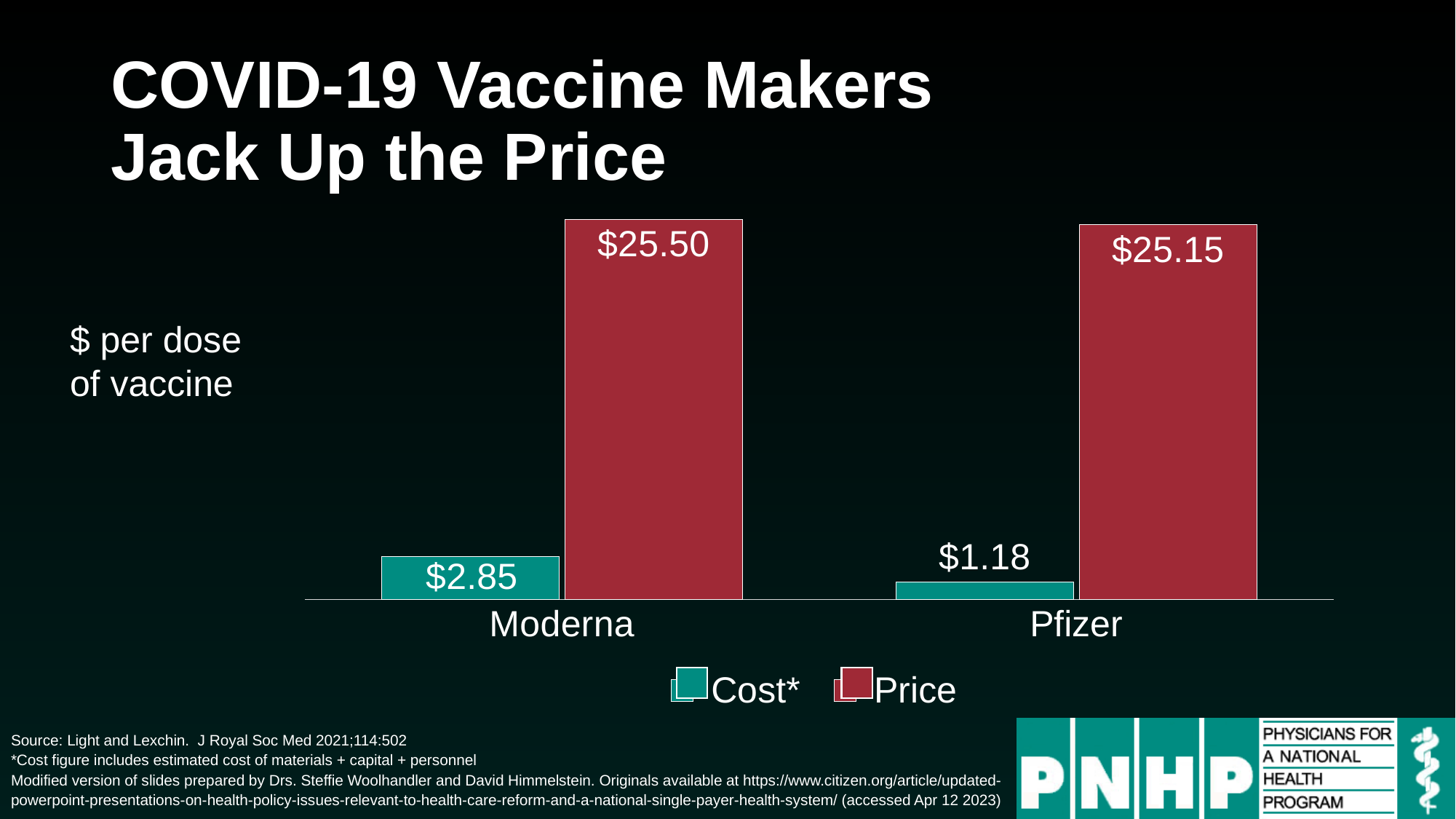
Which vaccine maker has the higher Price per dose? Moderna What kind of chart is shown on the slide? bar chart What is the Cost* per dose for Moderna? $2.85 What is the Price per dose for Moderna? $25.50 What is the Cost* per dose for Pfizer? $1.18 How many series does the legend list? 2 Is the Cost* per dose for Moderna larger or smaller than the Cost* per dose for Pfizer? larger What is the difference between the Price and the Cost* per dose for Pfizer? $23.97 What is the difference between the Price and the Cost* per dose for Moderna? $22.65 How many vaccine makers are shown on the x axis? 2 Which vaccine maker has the lower Cost* per dose? Pfizer What is the Price per dose for Pfizer? $25.15